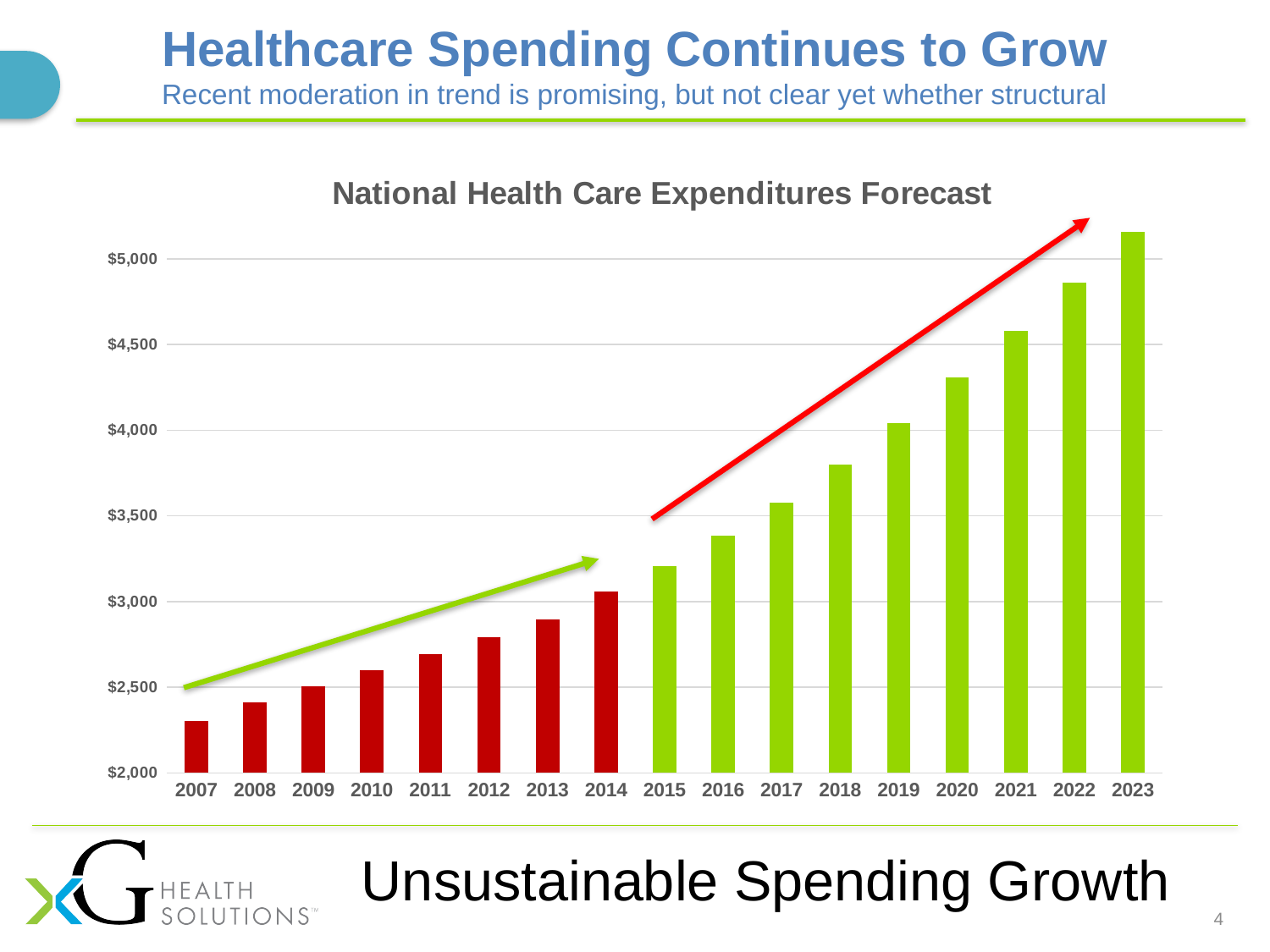
Is the value for 2018 greater or less than $4,000? less Do the values rise or fall from 2007 to 2023? rise Which year has the highest value in the chart? 2023 How many years are shown on the x axis of the chart? 17 Which is larger, the value for 2019 or the value for 2012? 2019 Is the value for 2007 greater or less than $2,500? less What is the title of the chart? National Health Care Expenditures Forecast What kind of chart is shown on the slide? bar chart Which year has the lowest value in the chart? 2007 Is the value for 2023 greater or less than $5,000? greater What colour are the bars for the years 2015 through 2023? green